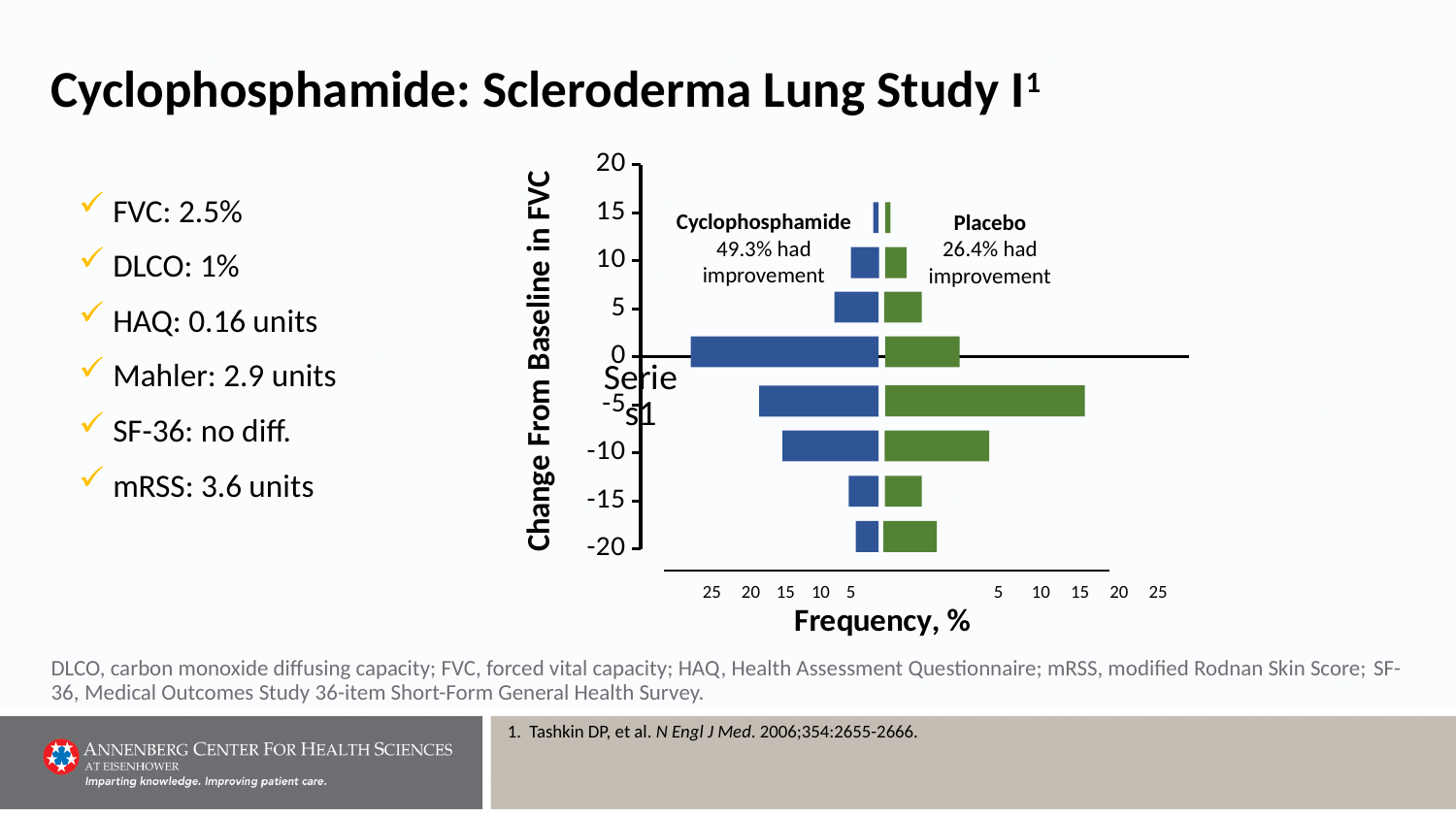
At which change-from-baseline level is the Placebo bar the longest? -5 At which change-from-baseline level is the Cyclophosphamide bar the shortest? 15 At a change from baseline of 0, which group has the higher frequency, Cyclophosphamide or Placebo? Cyclophosphamide According to the chart annotation, what percentage of the Placebo group had improvement? 26.4% How many change-from-baseline levels have bars plotted in the chart? 8 What is the title of the y-axis of the chart? Change From Baseline in FVC What kind of chart is shown on the slide? Bar chart By how many percentage points does the share with improvement in the Cyclophosphamide group exceed that in the Placebo group? 22.9% At a change from baseline of -5, which group has the higher frequency, Cyclophosphamide or Placebo? Placebo What is the title of the x-axis of the chart? Frequency, % According to the chart annotation, what percentage of the Cyclophosphamide group had improvement? 49.3% At which change-from-baseline level is the Cyclophosphamide bar the longest? 0